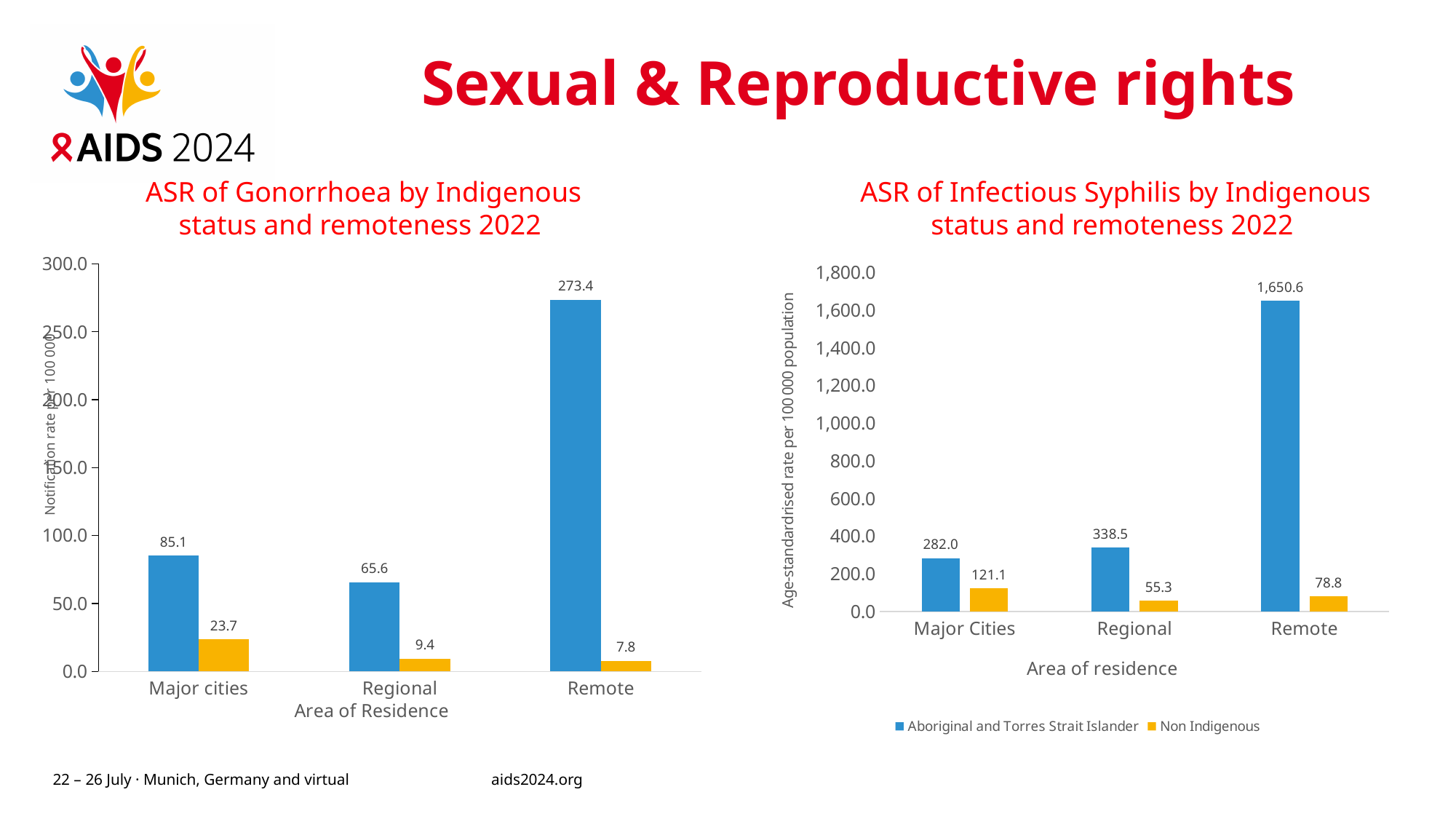
In the 'ASR of Infectious Syphilis by Indigenous status and remoteness 2022' chart, what is the value for Non Indigenous in Regional? 55.3 In the 'ASR of Gonorrhoea by Indigenous status and remoteness 2022' chart, what is the value of the blue bar for Remote? 273.4 In the 'ASR of Gonorrhoea by Indigenous status and remoteness 2022' chart, what is the value of the orange bar for Major cities? 23.7 In the 'ASR of Infectious Syphilis by Indigenous status and remoteness 2022' chart, which area of residence has the highest Non Indigenous value? Major Cities In the 'ASR of Gonorrhoea by Indigenous status and remoteness 2022' chart, how many areas of residence are shown on the x axis? 3 What type of chart is the 'ASR of Gonorrhoea by Indigenous status and remoteness 2022' chart? Bar chart In the 'ASR of Infectious Syphilis by Indigenous status and remoteness 2022' chart, what is the difference between the Aboriginal and Torres Strait Islander and Non Indigenous values for Major Cities? 160.9 How many series does the legend of the 'ASR of Infectious Syphilis by Indigenous status and remoteness 2022' chart list? 2 In the 'ASR of Gonorrhoea by Indigenous status and remoteness 2022' chart, what is the difference between the blue and orange bars for Regional? 56.2 In the 'ASR of Infectious Syphilis by Indigenous status and remoteness 2022' chart, what is the value for Aboriginal and Torres Strait Islander in Remote? 1,650.6 In the 'ASR of Infectious Syphilis by Indigenous status and remoteness 2022' chart, which is larger: the Aboriginal and Torres Strait Islander value for Major Cities or for Regional? Regional In the 'ASR of Gonorrhoea by Indigenous status and remoteness 2022' chart, which area of residence has the lowest orange bar? Remote